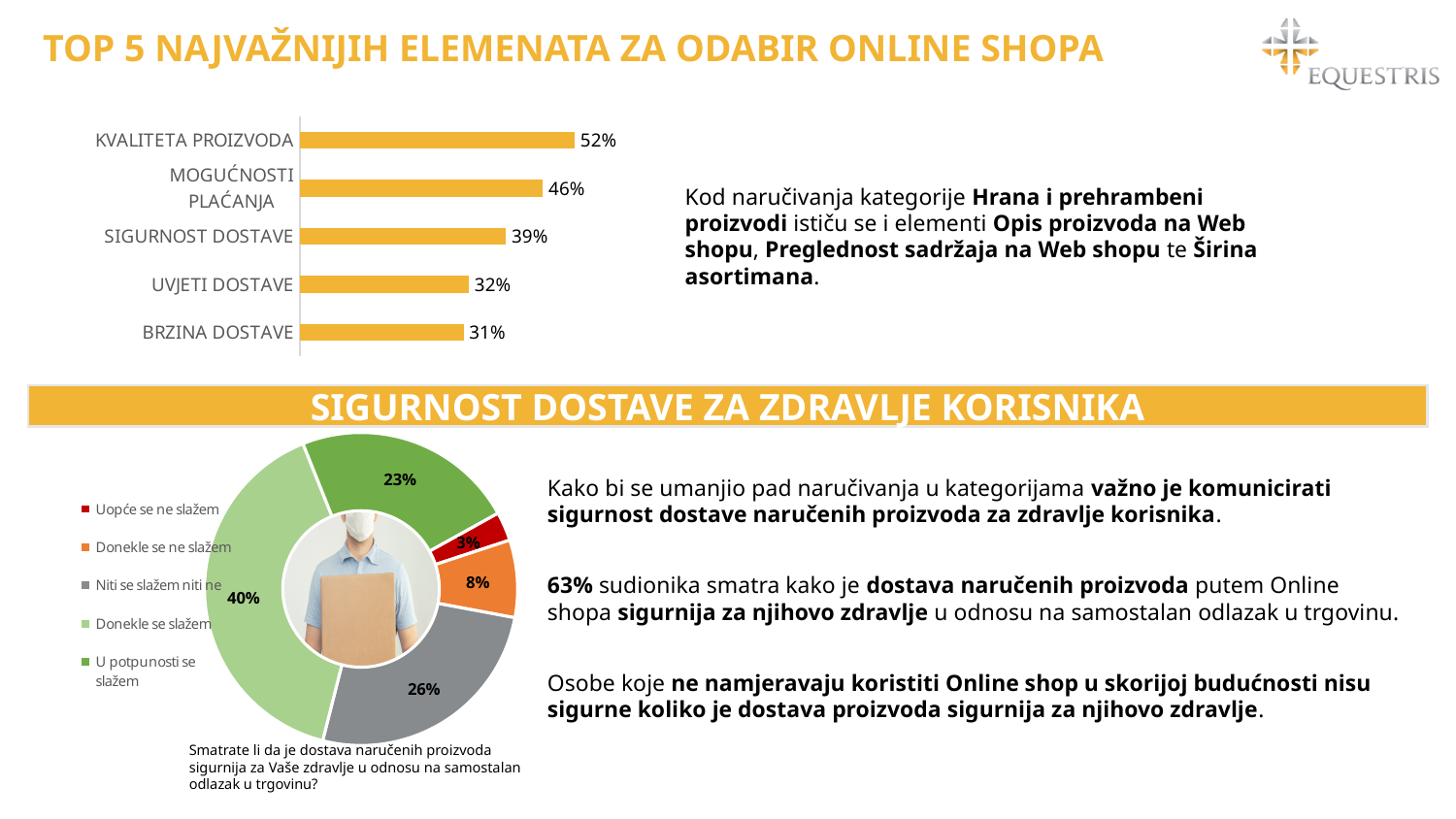
How many entries does the legend of the doughnut chart at the bottom of the slide list? 5 In the doughnut chart at the bottom of the slide, what share is shown for 'Uopće se ne slažem'? 3% In the bar chart at the top of the slide, how many categories are shown? 5 In the bar chart at the top of the slide, what is the difference between the values for KVALITETA PROIZVODA and UVJETI DOSTAVE? 20% In the doughnut chart at the bottom of the slide, which is larger: 'Niti se slažem niti ne' or 'U potpunosti se slažem'? Niti se slažem niti ne In the doughnut chart at the bottom of the slide, what is the combined share of 'Donekle se slažem' and 'U potpunosti se slažem'? 63% What kind of chart is the chart at the top of the slide? Bar chart In the bar chart at the top of the slide, which category has the lowest value? BRZINA DOSTAVE In the bar chart at the top of the slide, which category has the highest value? KVALITETA PROIZVODA In the bar chart at the top of the slide, what is the value for SIGURNOST DOSTAVE? 39% In the bar chart at the top of the slide, what is the value for KVALITETA PROIZVODA? 52% In the doughnut chart at the bottom of the slide, what share is shown for 'Donekle se slažem'? 40%